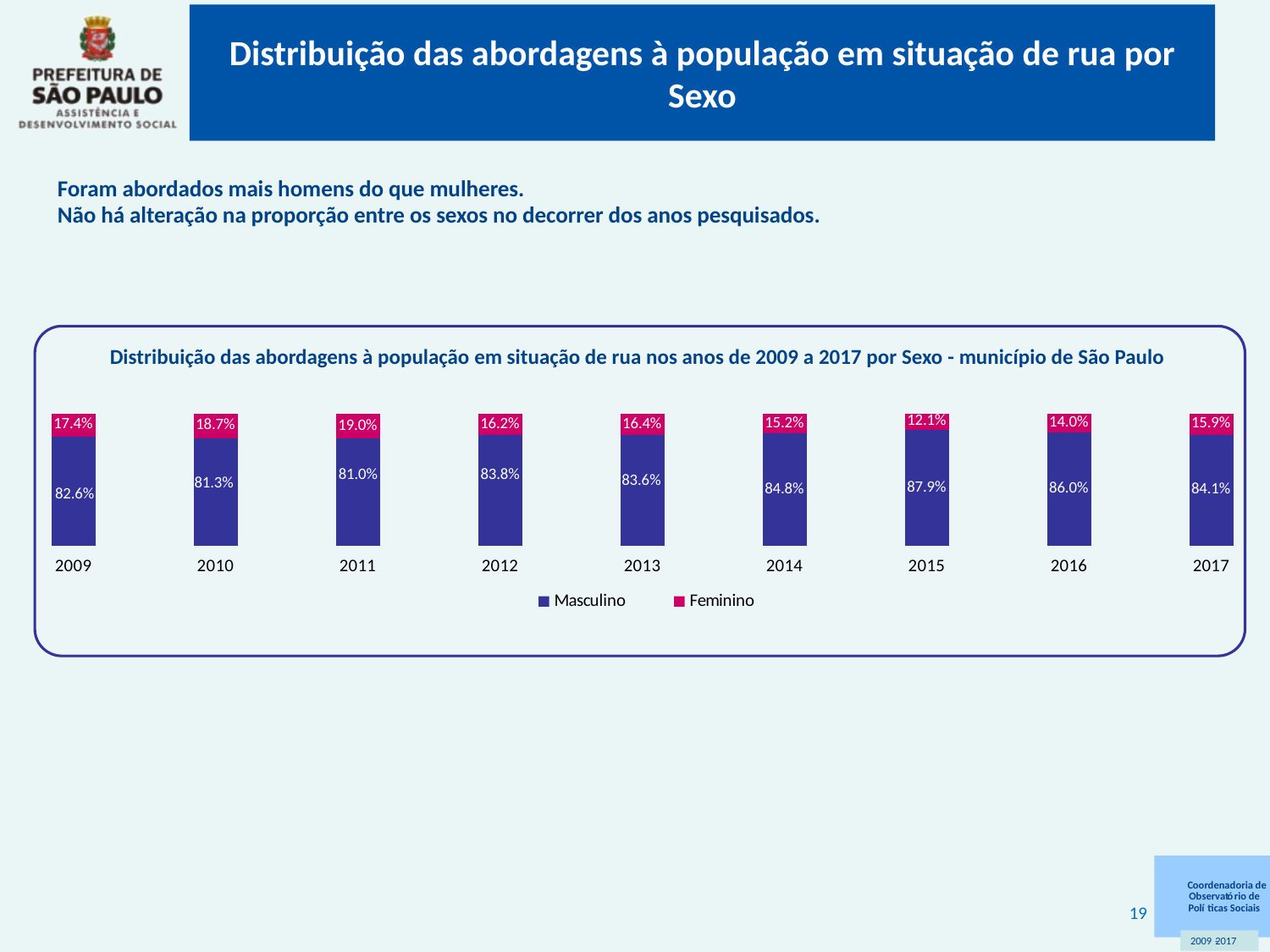
In which year is the Feminino share highest? 2011 How many series does the legend list? 2 What is the Feminino value for 2015? 12.1% What is the Masculino value for 2017? 84.1% What kind of chart is shown? Stacked bar chart In which year is the Feminino share lowest? 2015 What is the Feminino value for 2011? 19.0% How many years are shown on the x axis? 9 Which is larger, the Feminino value for 2010 or for 2016? 2010 What is the Masculino value for 2009? 82.6% In which year is the Masculino share highest? 2015 What is the difference between the Masculino and Feminino values in 2014? 69.6%